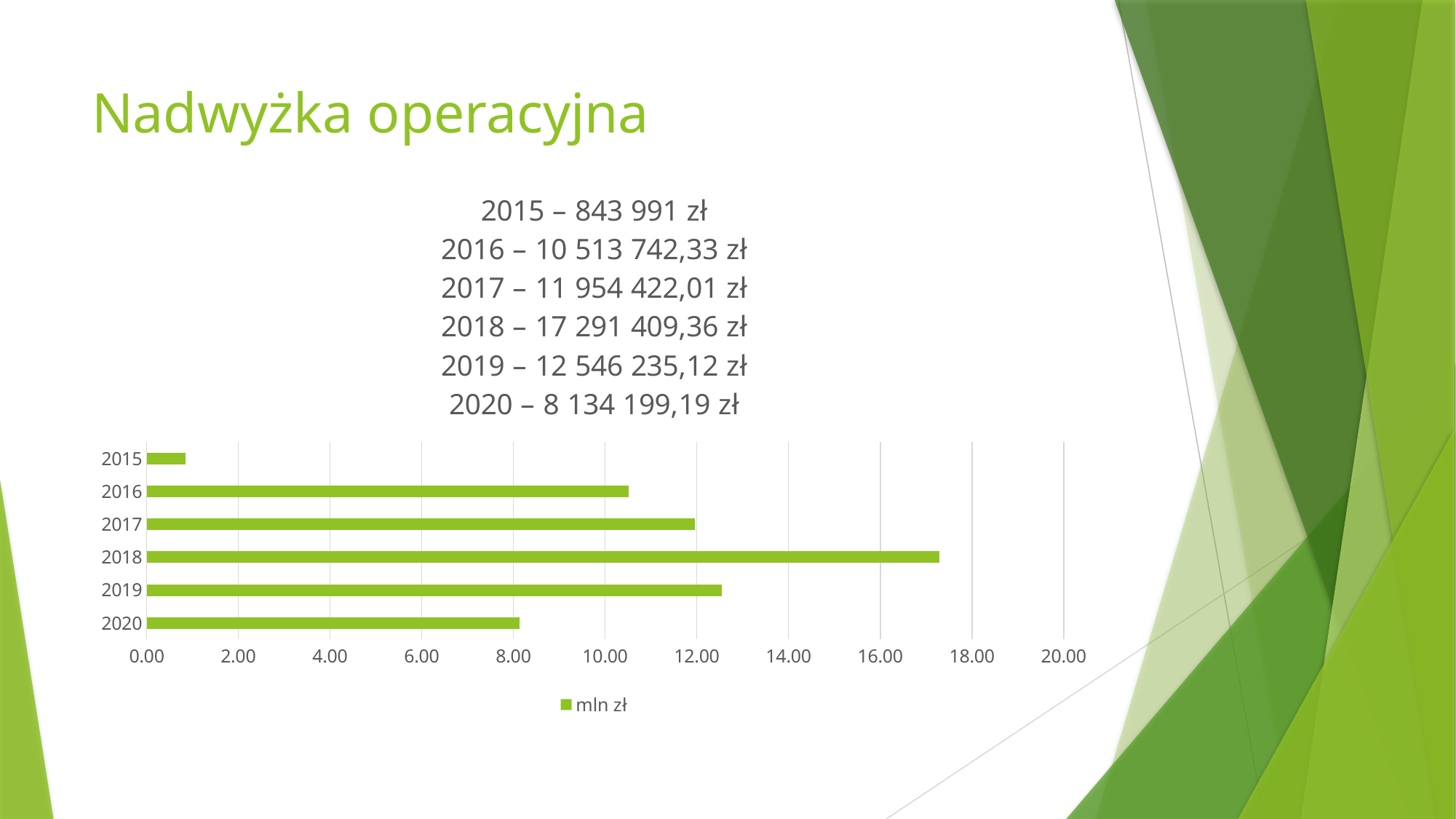
Is the value for 2020 greater or less than 10.00? less What kind of chart is shown on the slide? bar chart What is the legend entry of the chart? mln zł According to the text on the slide, what is the operating surplus for 2018? 17 291 409,36 zł Which year has the larger value, 2016 or 2019? 2019 Is the value for 2018 greater or less than 16.00? greater Which year has the shortest bar in the chart? 2015 Which year has the longest bar in the chart? 2018 Is the value for 2015 greater or less than 2.00? less How many series does the chart legend list? 1 How many years (categories) are plotted in the chart? 6 What is the title of the slide containing the chart? Nadwyżka operacyjna